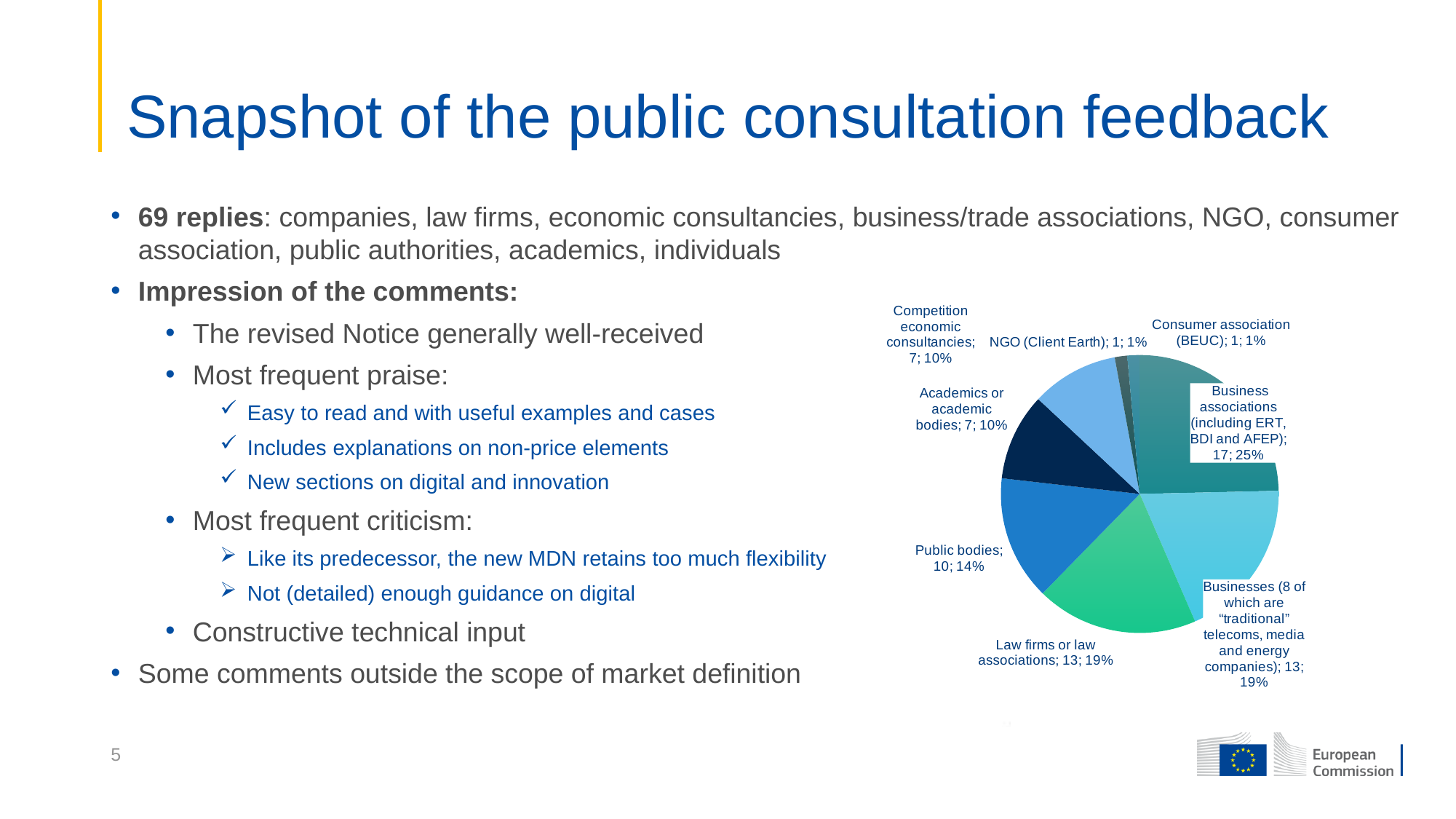
How many replies came from Law firms or law associations? 13 What percentage of replies came from Academics or academic bodies? 10% What kind of chart is shown on the slide? Pie chart Which category has more replies: Public bodies or Competition economic consultancies? Public bodies What is the total number of replies across all slices of the pie chart? 69 What share of the pie do Public bodies represent? 14% What is the difference in the number of replies between Business associations and Public bodies? 7 How many replies came from the NGO (Client Earth)? 1 How many categories does the pie chart show? 8 Which category has the largest slice of the pie chart? Business associations (including ERT, BDI and AFEP) How many replies came from Business associations (including ERT, BDI and AFEP)? 17 What share of the pie do Businesses (8 of which are "traditional" telecoms, media and energy companies) represent? 19%